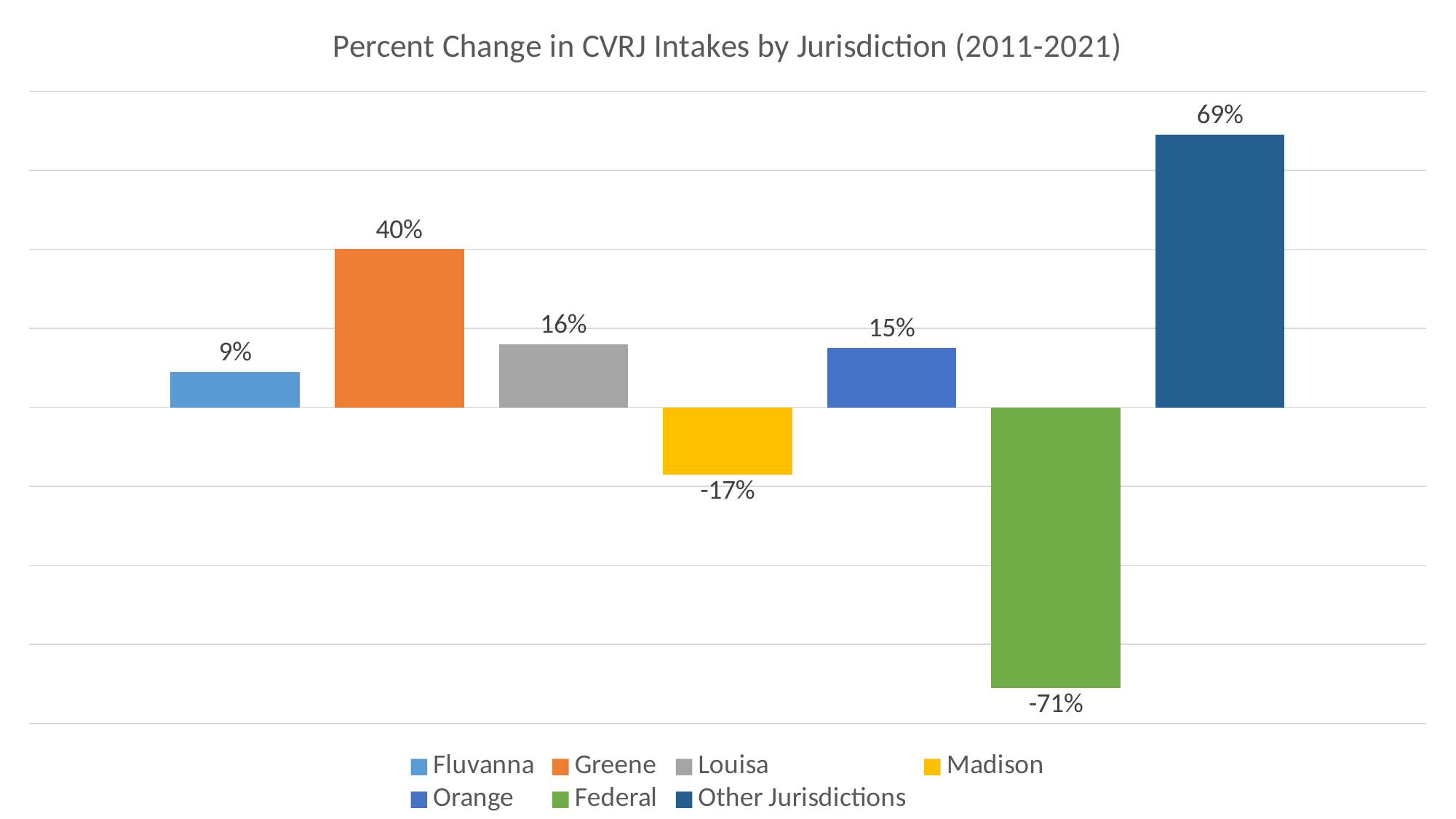
What is the percent change in CVRJ intakes for Greene? 40% Which has a larger percent change in CVRJ intakes, Louisa or Fluvanna? Louisa What is the title of the chart? Percent Change in CVRJ Intakes by Jurisdiction (2011-2021) Which jurisdiction has the highest percent change in CVRJ intakes? Other Jurisdictions How many jurisdictions are shown in the chart? 7 What type of chart is shown on the slide? Bar chart What is the percent change in CVRJ intakes for Madison? -17% What is the difference between the percent change for Other Jurisdictions and Greene? 29% What is the percent change in CVRJ intakes for Federal? -71% What colour is the bar for Madison? Yellow Which jurisdiction has the lowest percent change in CVRJ intakes? Federal What is the percent change in CVRJ intakes for Fluvanna? 9%